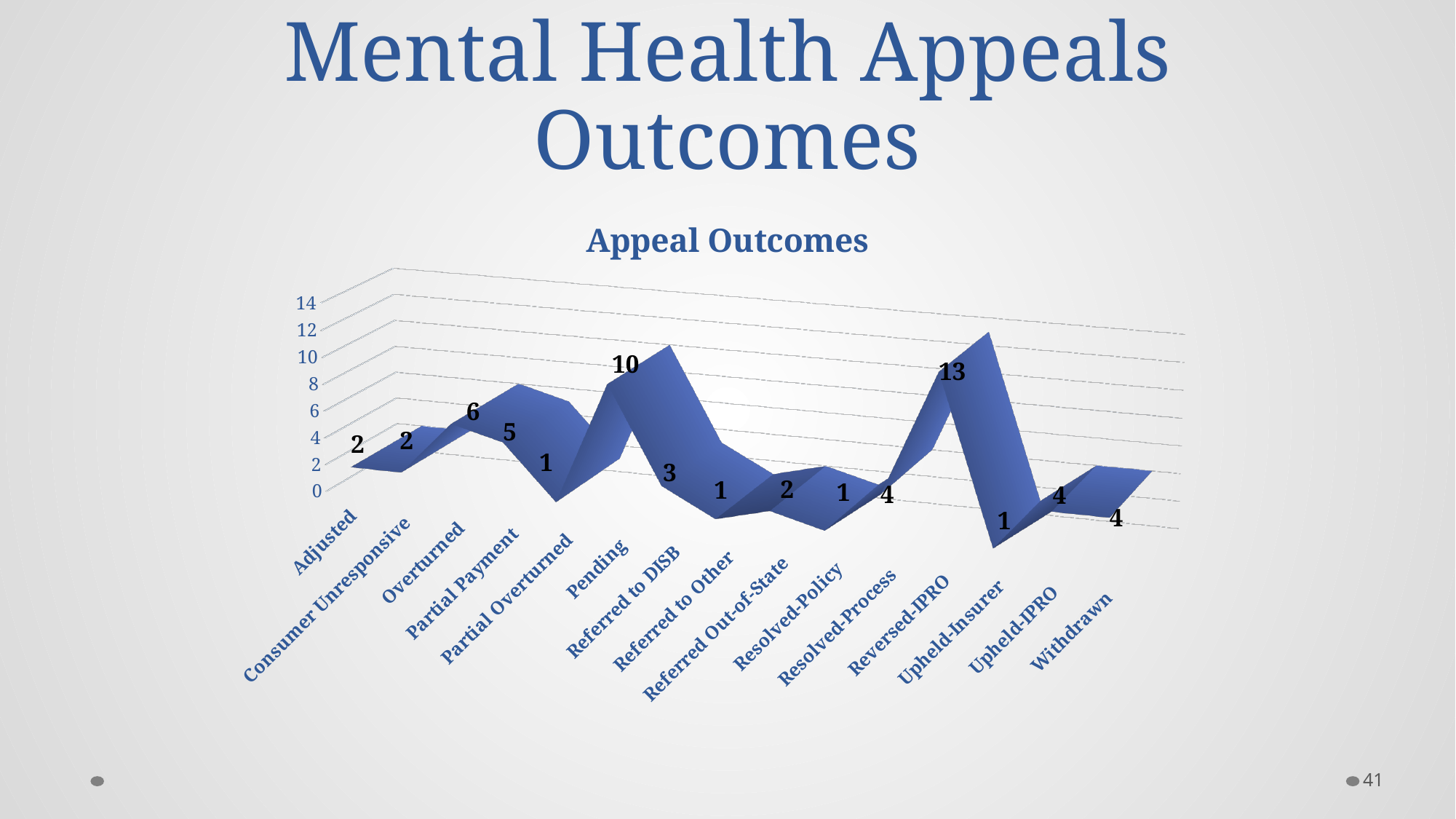
What is the value for Overturned? 6 Is the value for Pending greater or less than 8? greater What is the value for Reversed-IPRO? 13 What kind of chart is shown on the slide? line chart What is the value for Referred to DISB? 3 What is the difference between the values for Reversed-IPRO and Pending? 3 Which is larger, the value for Resolved-Process or the value for Resolved-Policy? Resolved-Process What is the value for Pending? 10 Which category has the highest value? Reversed-IPRO How many categories are shown on the x axis? 15 What is the difference between the values for Overturned and Partial Payment? 1 What is the title of the chart? Appeal Outcomes